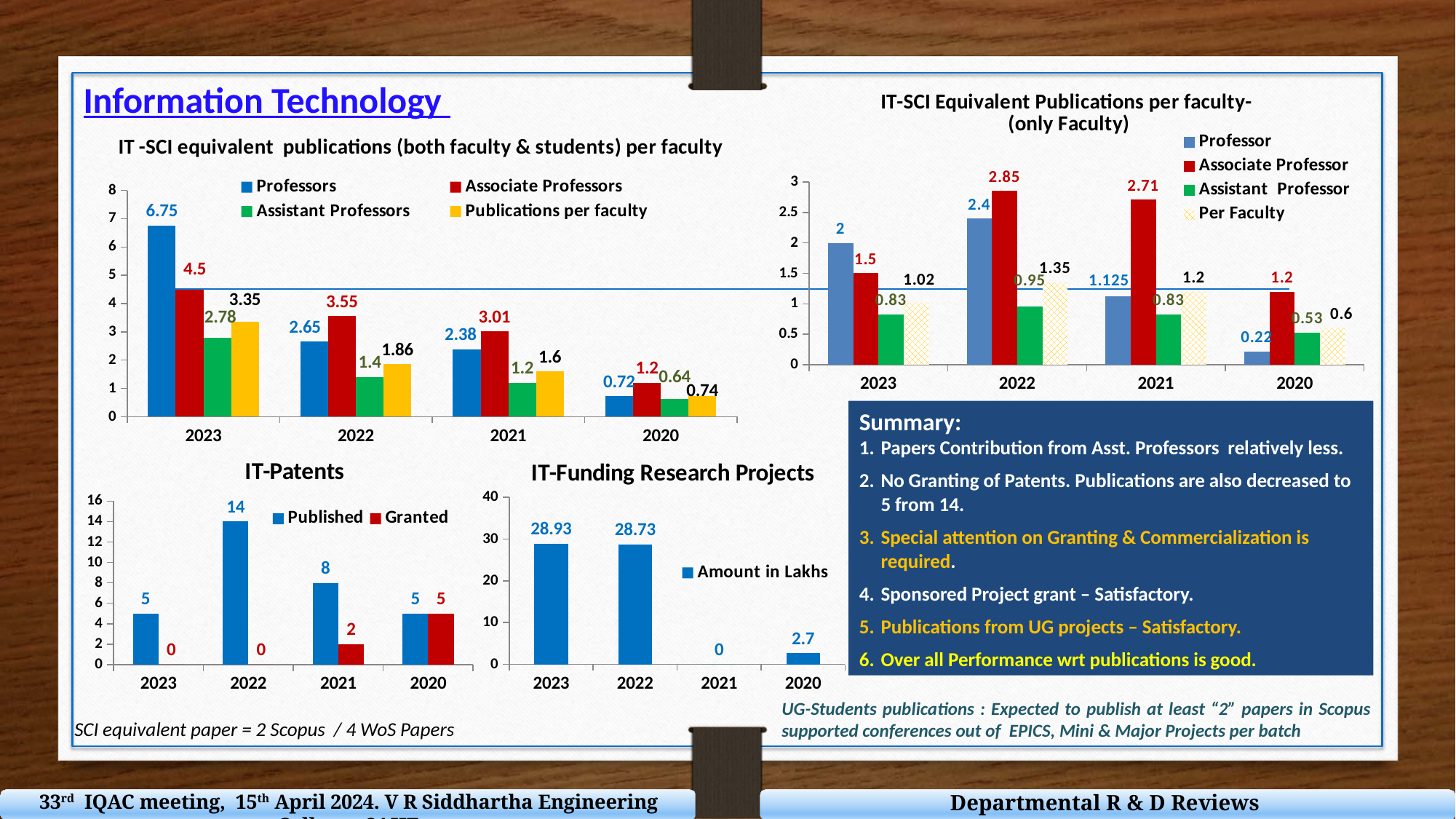
In the 'IT -SCI equivalent publications (both faculty & students) per faculty' chart, what is the difference between the Associate Professors value and the Assistant Professors value in 2022? 2.15 In the 'IT -SCI equivalent publications (both faculty & students) per faculty' chart, what is the value for Professors in 2023? 6.75 In the 'IT-SCI Equivalent Publications per faculty- (only Faculty)' chart, which year has the highest Professor value? 2022 In the 'IT-Funding Research Projects' chart, how many years are shown on the x axis? 4 In the 'IT -SCI equivalent publications (both faculty & students) per faculty' chart, how many series does the legend list? 4 In the 'IT-Funding Research Projects' chart, what is the Amount in Lakhs for 2020? 2.7 In the 'IT -SCI equivalent publications (both faculty & students) per faculty' chart, which year has the lowest Publications per faculty value? 2020 In the 'IT-Patents' chart, how many patents were Published in 2022? 14 In the 'IT-SCI Equivalent Publications per faculty- (only Faculty)' chart, what is the Associate Professor value for 2021? 2.71 What kind of chart is the 'IT-Patents' chart? Bar chart In the 'IT-SCI Equivalent Publications per faculty- (only Faculty)' chart, which is larger in 2023: the Professor value or the Associate Professor value? Professor In the 'IT-Patents' chart, what is the difference between Published and Granted patents in 2021? 6